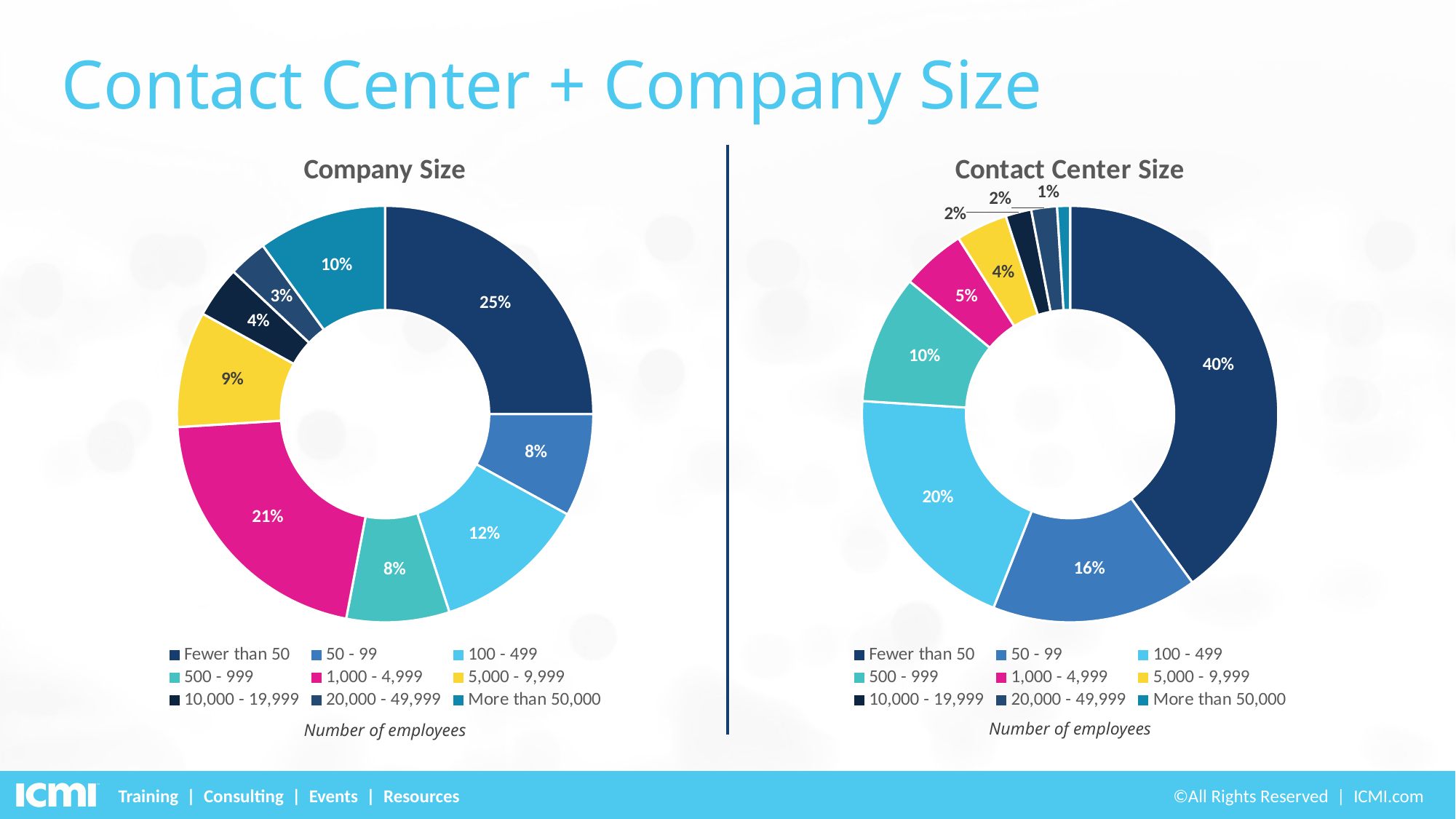
In the Company Size chart, what share is labelled for the More than 50,000 slice? 10% In the Contact Center Size chart, what share is labelled for the 100 - 499 slice? 20% In the Company Size chart, what share is labelled for the 1,000 - 4,999 slice? 21% In the Contact Center Size chart, which is larger: the 50 - 99 slice or the 500 - 999 slice? 50 - 99 What is the axis note printed below the legend of each chart? Number of employees How many categories does the Company Size chart show? 9 In the Contact Center Size chart, what share is labelled for the Fewer than 50 slice? 40% In the Company Size chart, which category has the smallest slice? 20,000 - 49,999 In the Company Size chart, which category has the largest slice? Fewer than 50 What is the difference between the Fewer than 50 share in the Contact Center Size chart and the Fewer than 50 share in the Company Size chart? 15% What kind of chart is the Contact Center Size chart? Doughnut (pie) chart In the Contact Center Size chart, which category has the smallest slice? More than 50,000